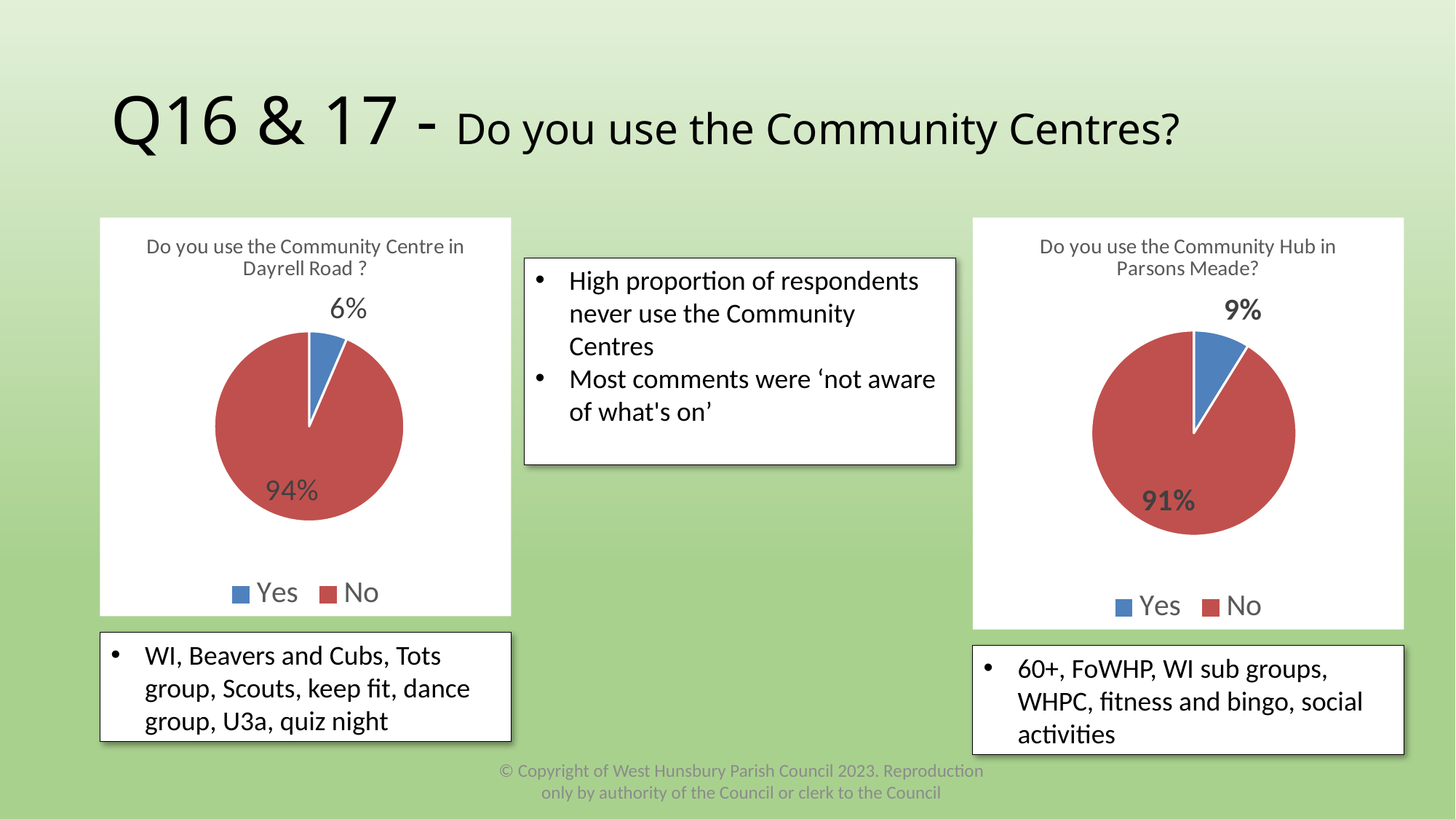
How many slices does the 'Do you use the Community Centre in Dayrell Road ?' pie chart have? 2 In the 'Do you use the Community Centre in Dayrell Road ?' chart, what is the difference between the No and Yes shares? 88% What type of chart is the 'Do you use the Community Hub in Parsons Meade?' chart? Pie chart In the 'Do you use the Community Centre in Dayrell Road ?' chart, which response has the largest share? No In the 'Do you use the Community Hub in Parsons Meade?' chart, what colour represents No? Red In the 'Do you use the Community Centre in Dayrell Road ?' chart, what percentage answered No? 94% In the 'Do you use the Community Hub in Parsons Meade?' chart, which response has the smallest share? Yes In the 'Do you use the Community Centre in Dayrell Road ?' chart, what percentage answered Yes? 6% In the 'Do you use the Community Hub in Parsons Meade?' chart, what percentage answered Yes? 9% In the 'Do you use the Community Hub in Parsons Meade?' chart, what percentage answered No? 91% In the 'Do you use the Community Hub in Parsons Meade?' chart, what is the difference between the No and Yes shares? 82% Which chart has the larger Yes share, the Dayrell Road chart or the Parsons Meade chart? Parsons Meade